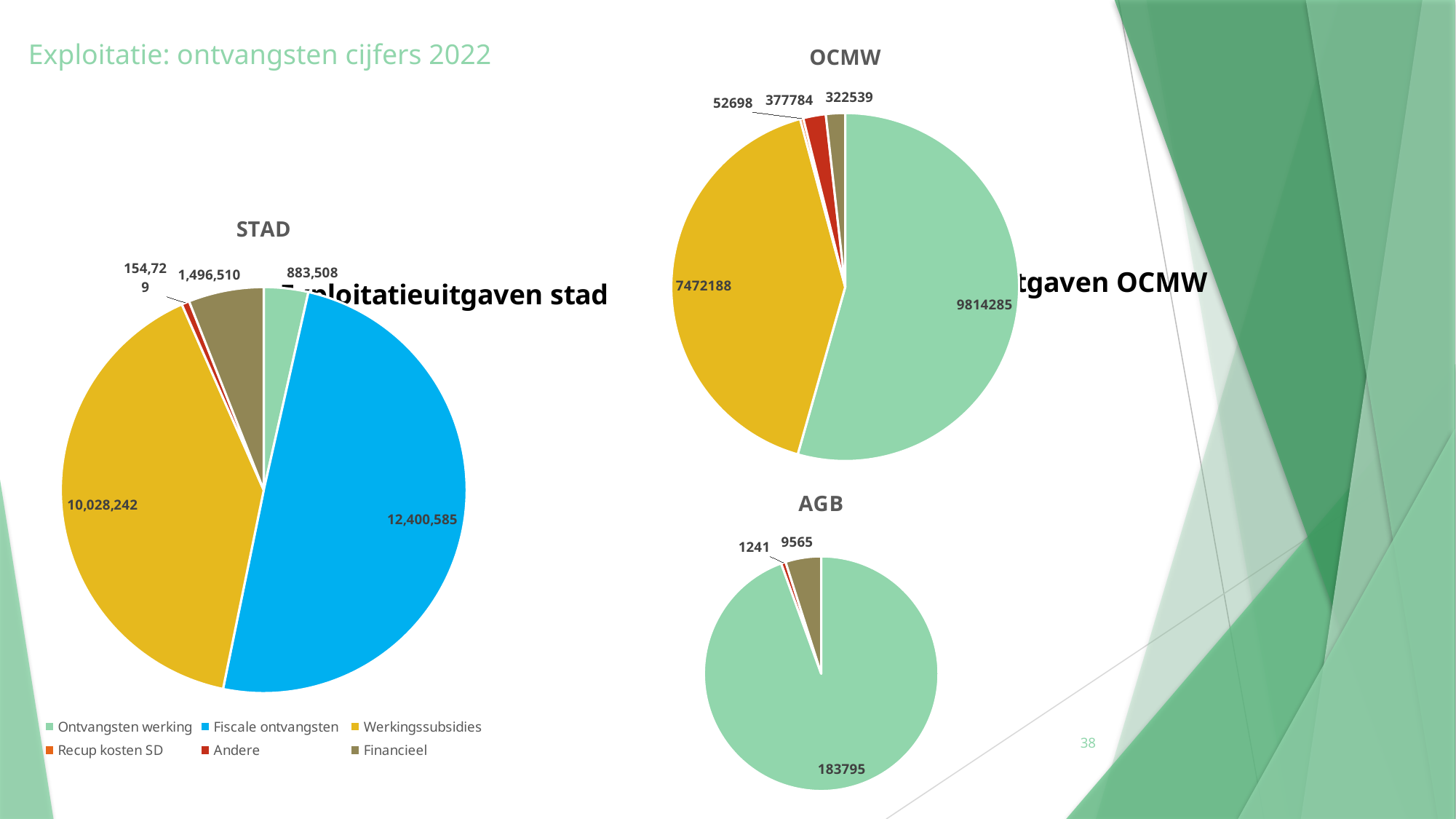
In the OCMW pie chart, what is the value of the largest slice? 9814285 In the STAD pie chart, what is the value for Financieel? 1,496,510 In the STAD pie chart, what is the difference between Fiscale ontvangsten and Werkingssubsidies? 2,372,343 In the AGB pie chart, what is the value of the smallest slice? 1241 In the STAD pie chart, what is the value for Werkingssubsidies? 10,028,242 In the STAD pie chart, which category has the largest slice? Fiscale ontvangsten In the STAD pie chart, what is the value for Fiscale ontvangsten? 12,400,585 In the OCMW pie chart, what is the value of the yellow slice? 7472188 How many entries does the legend below the STAD chart list? 6 In the OCMW pie chart, what is the difference between the two largest slices (9814285 and 7472188)? 2342097 In the STAD pie chart, which is larger: Ontvangsten werking or Financieel? Financieel In the AGB pie chart, what is the value of the largest slice? 183795